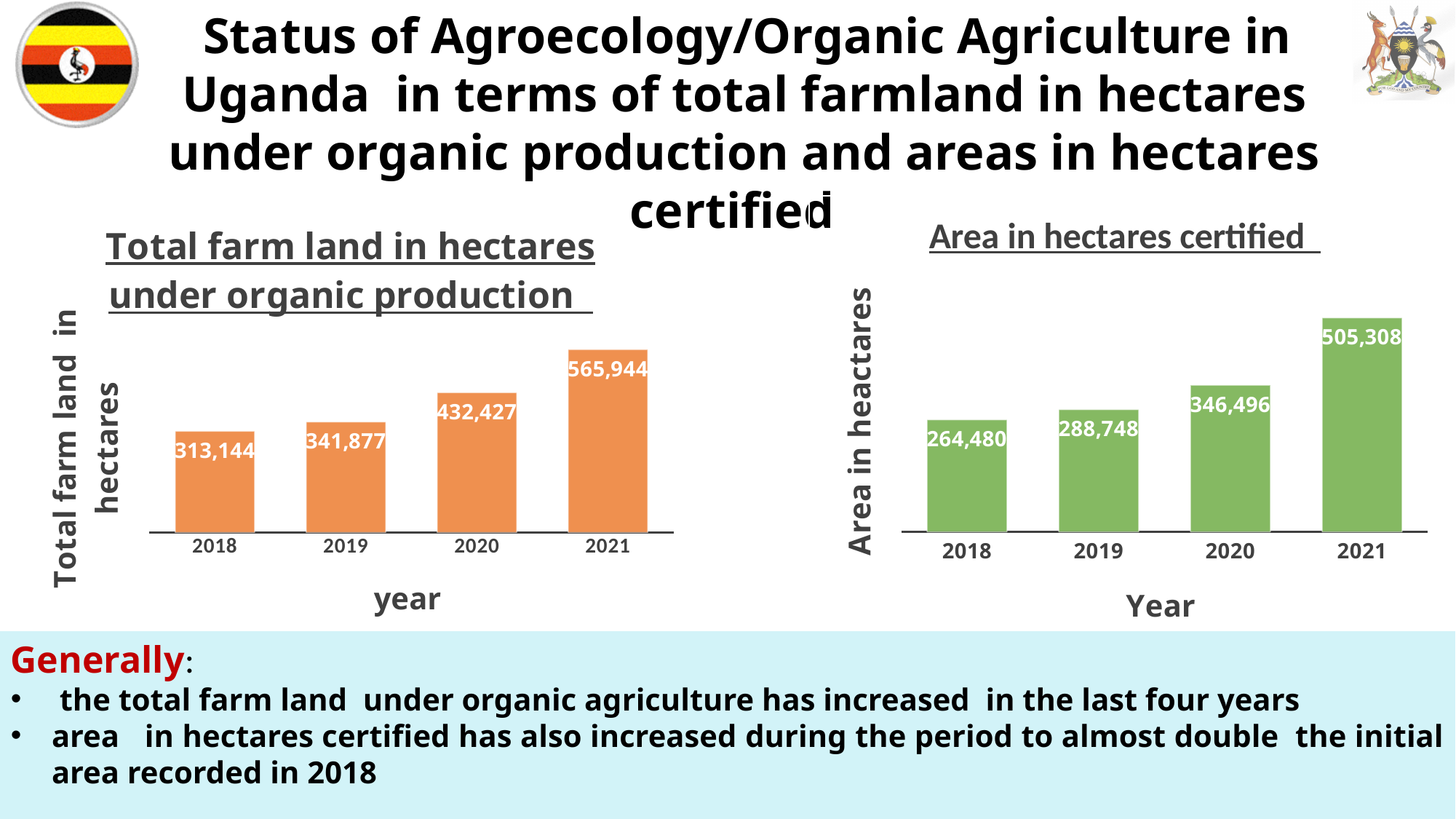
How many years are shown on the x axis of the 'Total farm land in hectares under organic production' chart? 4 What colour are the bars in the 'Total farm land in hectares under organic production' chart? Orange What kind of chart is the 'Area in hectares certified' chart? Bar chart In the 'Area in hectares certified' chart, which is larger, the value for 2020 or the value for 2019? 2020 In the 'Total farm land in hectares under organic production' chart, what is the value for 2020? 432,427 In the 'Total farm land in hectares under organic production' chart, which year has the highest value? 2021 In the 'Area in hectares certified' chart, which year has the lowest value? 2018 In the 'Area in hectares certified' chart, what is the difference between the 2021 and 2018 values? 240,828 In the 'Total farm land in hectares under organic production' chart, do the values rise or fall from 2018 to 2021? Rise In the 'Area in hectares certified' chart, what is the value for 2019? 288,748 What is the x-axis label of the 'Area in hectares certified' chart? Year In the 'Total farm land in hectares under organic production' chart, what is the difference between the 2021 and 2018 values? 252,800